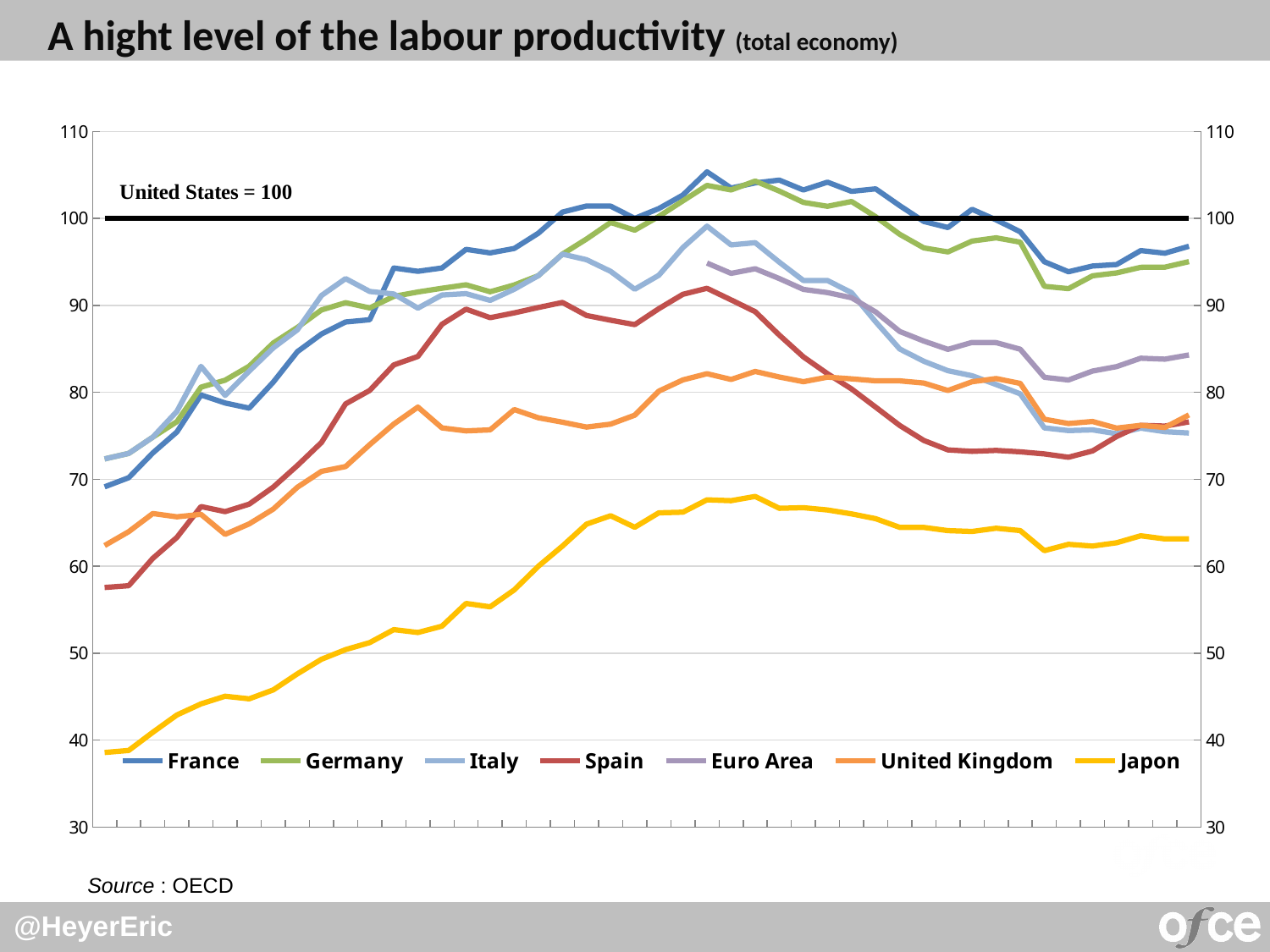
What is the source cited for the chart? OECD Is the last value of the Germany series greater or less than 90? greater At the right end of the chart, which is higher: France or Italy? France Is the first value of the Spain series greater or less than 60? less Is the highest value reached by United Kingdom greater or less than 90? less Which series stays lowest across the whole chart? Japon Does the Japon series overall rise or fall from the left end of the chart to the right end? rise What does the thick black horizontal line on the chart represent? United States = 100 What kind of chart is shown on the slide? line chart How many series does the legend list? 7